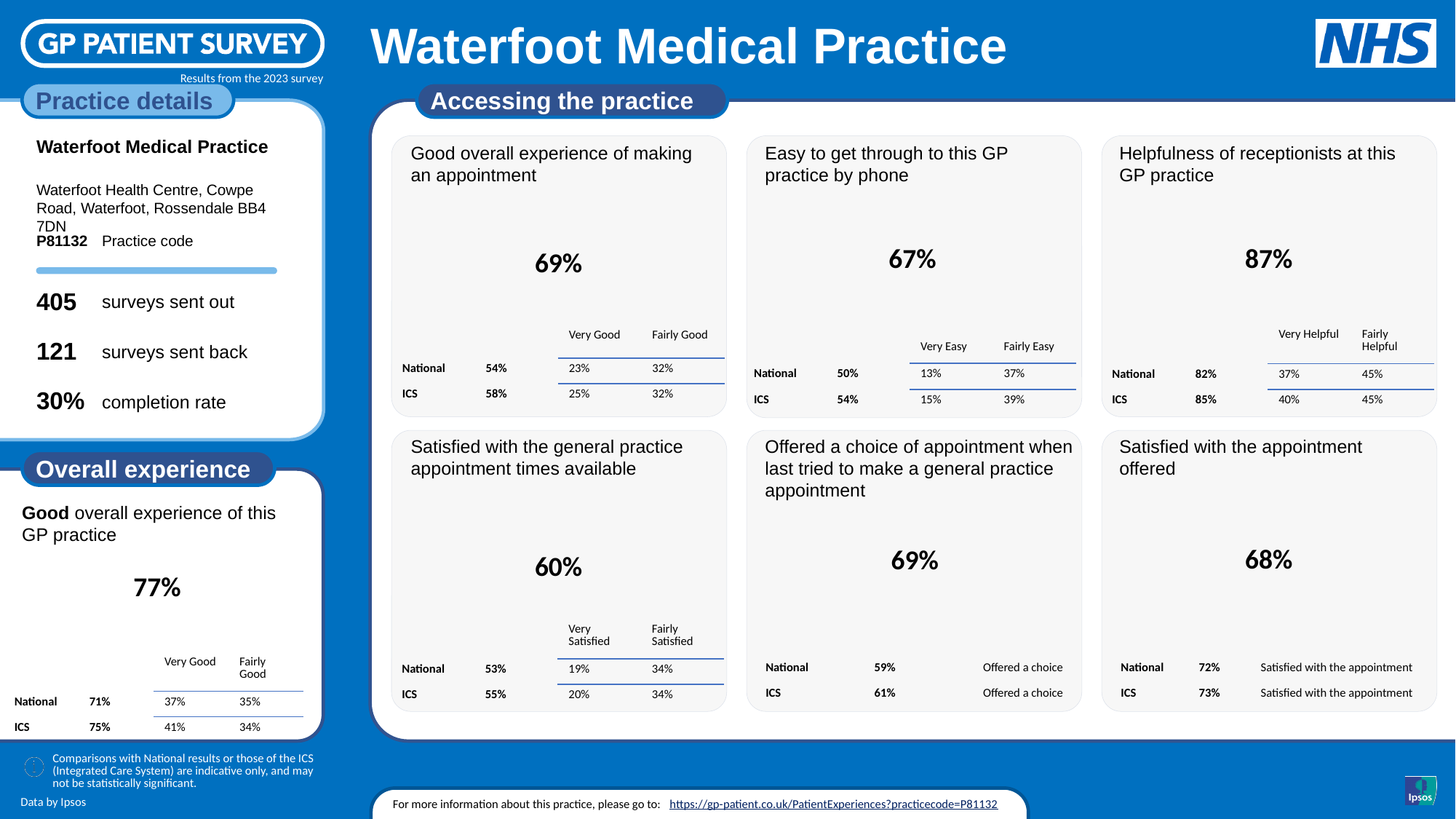
In the 'Satisfied with the appointment offered' panel, what is the difference between the ICS value and the National value? 1% In the 'Easy to get through to this GP practice by phone' panel, what is the National value? 50% How many panels are shown under the 'Accessing the practice' heading? 6 Among the six 'Accessing the practice' panels, which has the highest headline percentage? Helpfulness of receptionists at this GP practice In the 'Good overall experience of this GP practice' panel under Overall experience, what is the practice's headline percentage? 77% In the 'Offered a choice of appointment when last tried to make a general practice appointment' panel, is the practice's headline percentage larger than the ICS value? Yes, 69% vs 61% In the 'Satisfied with the general practice appointment times available' panel, what is the National 'Very Satisfied' value? 19% In the 'Helpfulness of receptionists at this GP practice' panel, what is the ICS value? 85% In the 'Helpfulness of receptionists at this GP practice' panel, what is the difference between the practice's headline percentage and the National value? 5% In the 'Good overall experience of making an appointment' panel, what is the practice's headline percentage? 69% In the 'Good overall experience of this GP practice' panel, what is the ICS 'Very Good' value? 41% Among the six 'Accessing the practice' panels, which has the lowest headline percentage? Satisfied with the general practice appointment times available